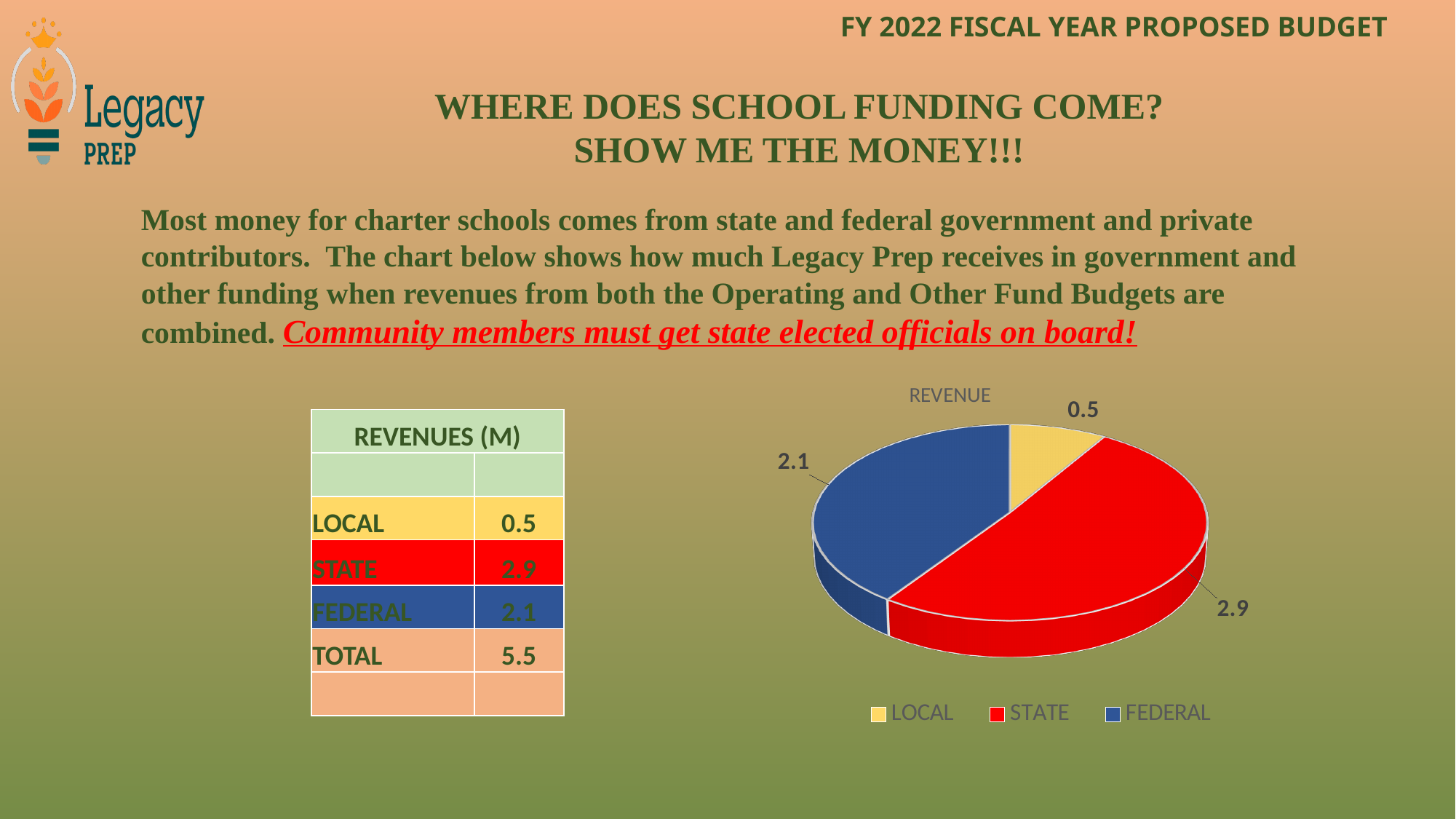
Which is larger in the pie chart, FEDERAL or LOCAL? FEDERAL How many slices does the pie chart have? 3 What colour is the STATE slice in the pie chart? red What is the value of the STATE slice in the pie chart? 2.9 What is the difference between the STATE and FEDERAL values in the pie chart? 0.8 What is the value of the FEDERAL slice in the pie chart? 2.1 What is the value of the LOCAL slice in the pie chart? 0.5 What type of chart is shown on the slide? pie chart What is the title of the pie chart? REVENUE How many entries does the pie chart legend list? 3 Which category has the largest slice in the pie chart? STATE Which category has the smallest slice in the pie chart? LOCAL